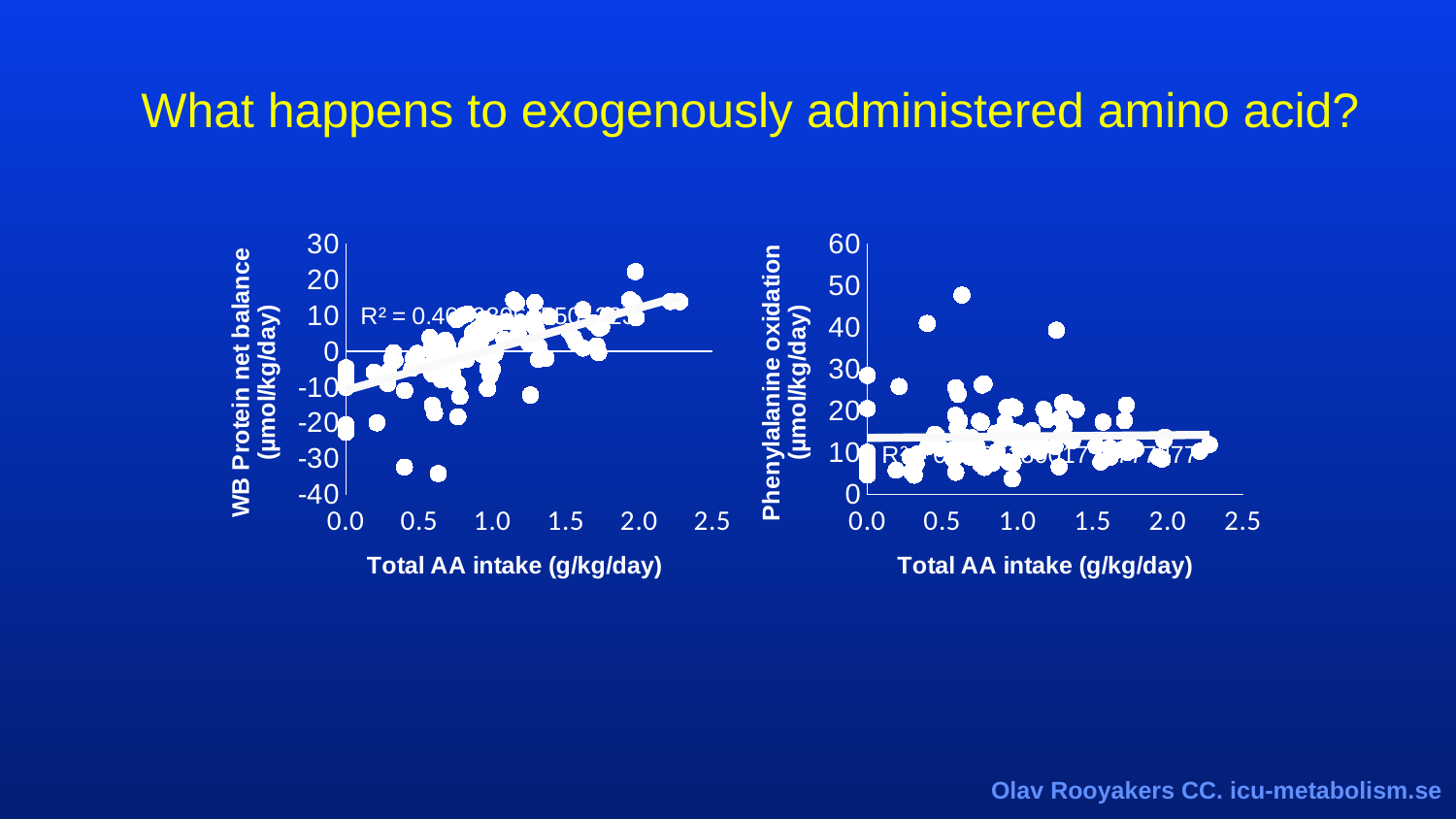
In the right chart (Phenylalanine oxidation), is the lowest plotted point greater or less than 10? less In the right chart (Phenylalanine oxidation), does the trend line rise noticeably, fall noticeably, or stay roughly flat as Total AA intake increases? roughly flat In the left chart (WB Protein net balance), does the trend line rise or fall as Total AA intake increases? rises In the right chart (Phenylalanine oxidation), is the highest plotted point greater or less than 40? greater What is the largest tick value shown on the x-axis of the right chart (Phenylalanine oxidation)? 2.5 How many charts are shown on the slide? 2 What is the y-axis label of the right chart? Phenylalanine oxidation (µmol/kg/day) What is the x-axis label of the left chart (WB Protein net balance)? Total AA intake (g/kg/day) What is the lowest tick value shown on the y-axis of the left chart (WB Protein net balance)? -40 In the left chart (WB Protein net balance), is the lowest plotted point greater or less than -30? less What kind of chart is the left chart, titled 'WB Protein net balance'? scatter plot What kind of chart is the right chart, titled 'Phenylalanine oxidation'? scatter plot